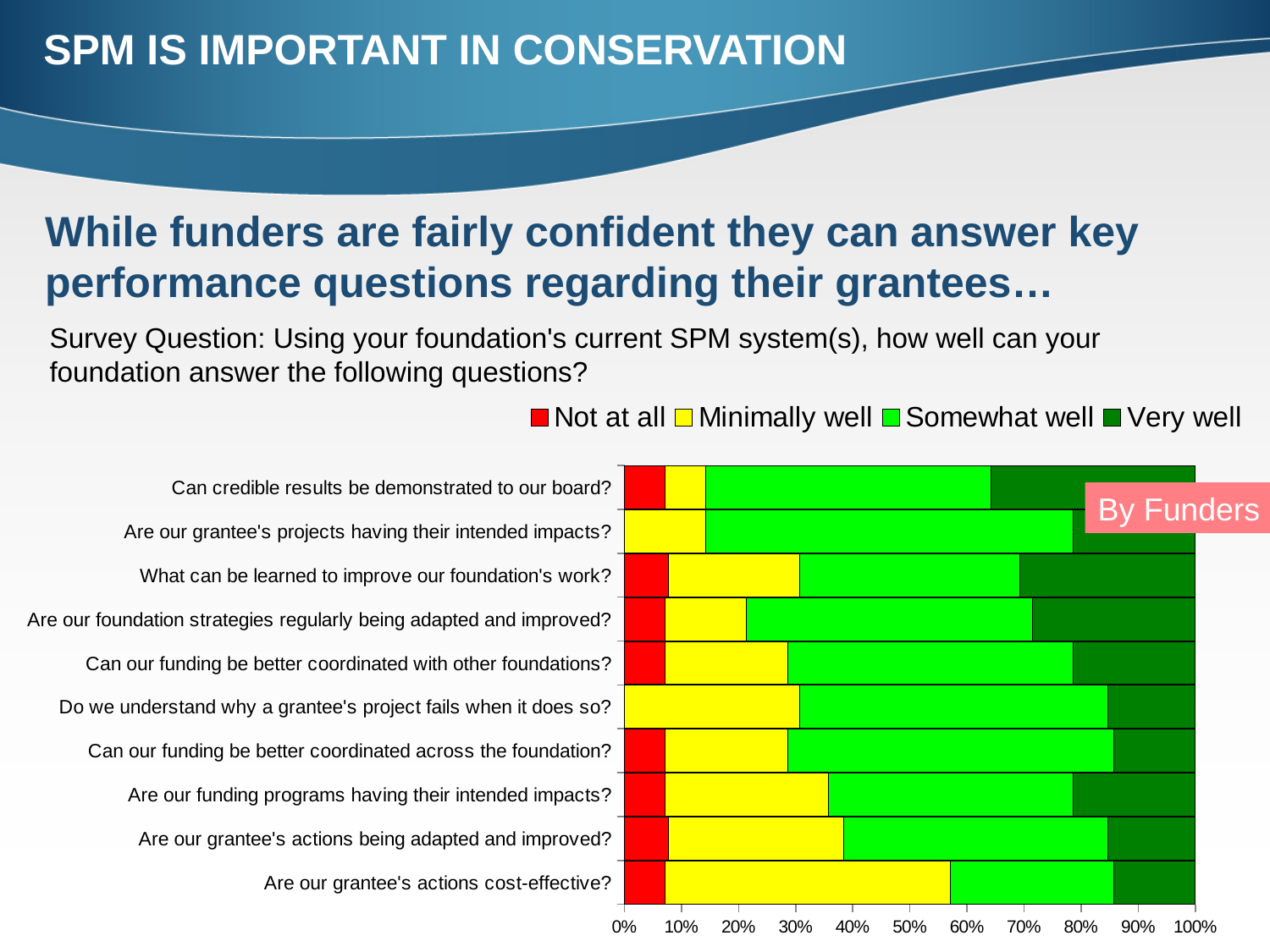
Is the 'Very well' share for 'Can credible results be demonstrated to our board?' greater or less than 30%? greater What are the four response categories listed in the legend? Not at all, Minimally well, Somewhat well, Very well How many series does the chart legend list? 4 How many survey questions (categories) are plotted on the chart? 10 Which colour represents the 'Not at all' response in the chart? Red Is the 'Very well' share for 'Are our grantee's actions cost-effective?' greater or less than 20%? less What is the highest value shown on the horizontal axis? 100% What kind of chart is shown on the slide? Stacked bar chart Is the 'Minimally well' share for 'Are our grantee's actions cost-effective?' greater or less than 40%? greater Which has the larger 'Minimally well' share: 'Are our grantee's actions cost-effective?' or 'Can credible results be demonstrated to our board?' Are our grantee's actions cost-effective? Which survey question has the largest 'Minimally well' share? Are our grantee's actions cost-effective? How many survey questions show no 'Not at all' (red) segment? 2